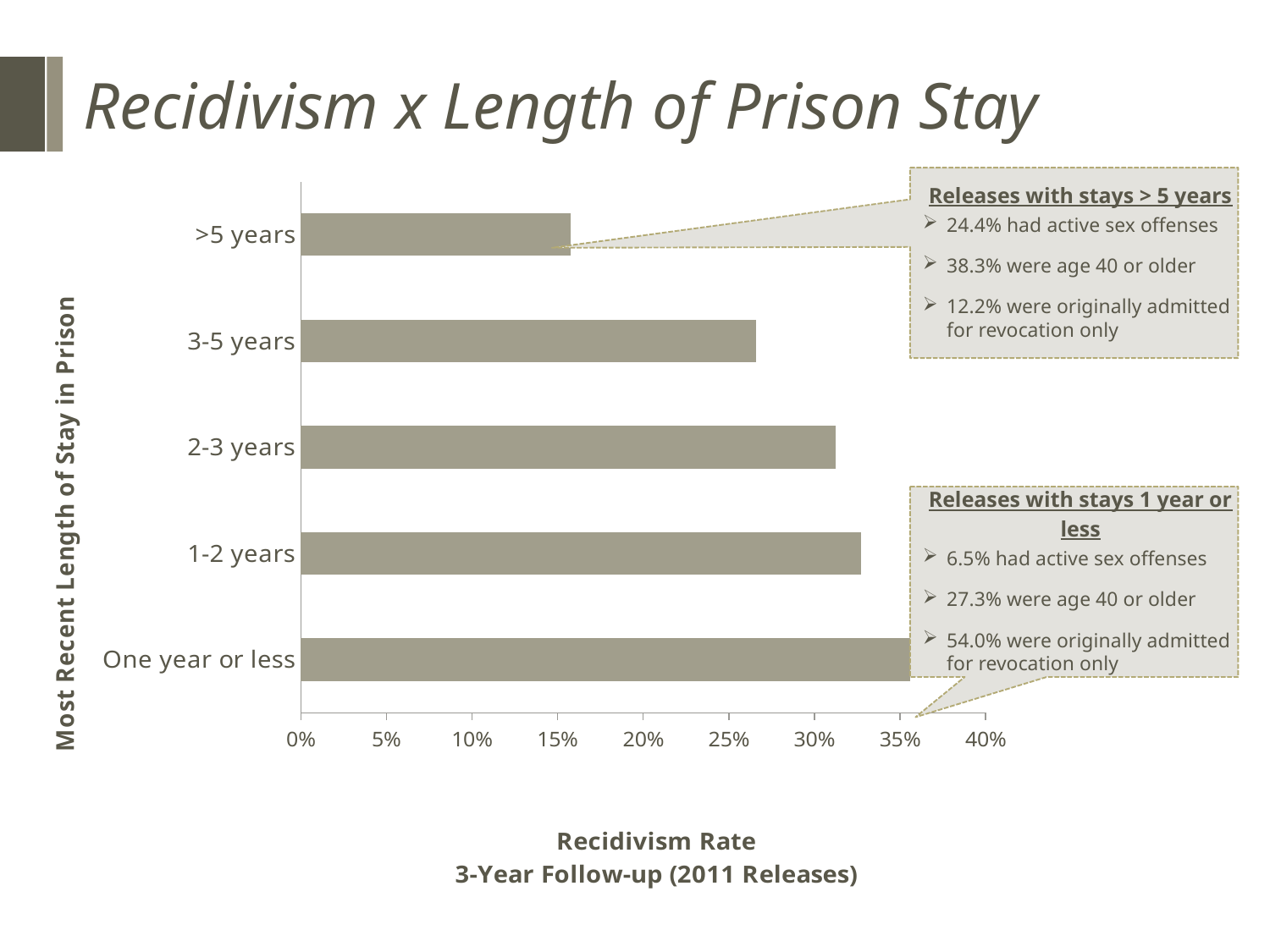
Is the recidivism rate for 1-2 years greater or less than 30%? greater What is the title of the vertical axis of the chart? Most Recent Length of Stay in Prison Is the recidivism rate for 3-5 years greater or less than 25%? greater As the length of prison stay increases, does the recidivism rate rise or fall? fall How many length-of-stay categories are plotted in the chart? 5 Is the recidivism rate for >5 years greater or less than 20%? less Which length-of-stay category has the highest recidivism rate? One year or less What kind of chart is shown on the slide? Bar chart Which has a higher recidivism rate, >5 years or 1-2 years? 1-2 years Which length-of-stay category has the lowest recidivism rate? >5 years Which has a higher recidivism rate, 2-3 years or 3-5 years? 2-3 years